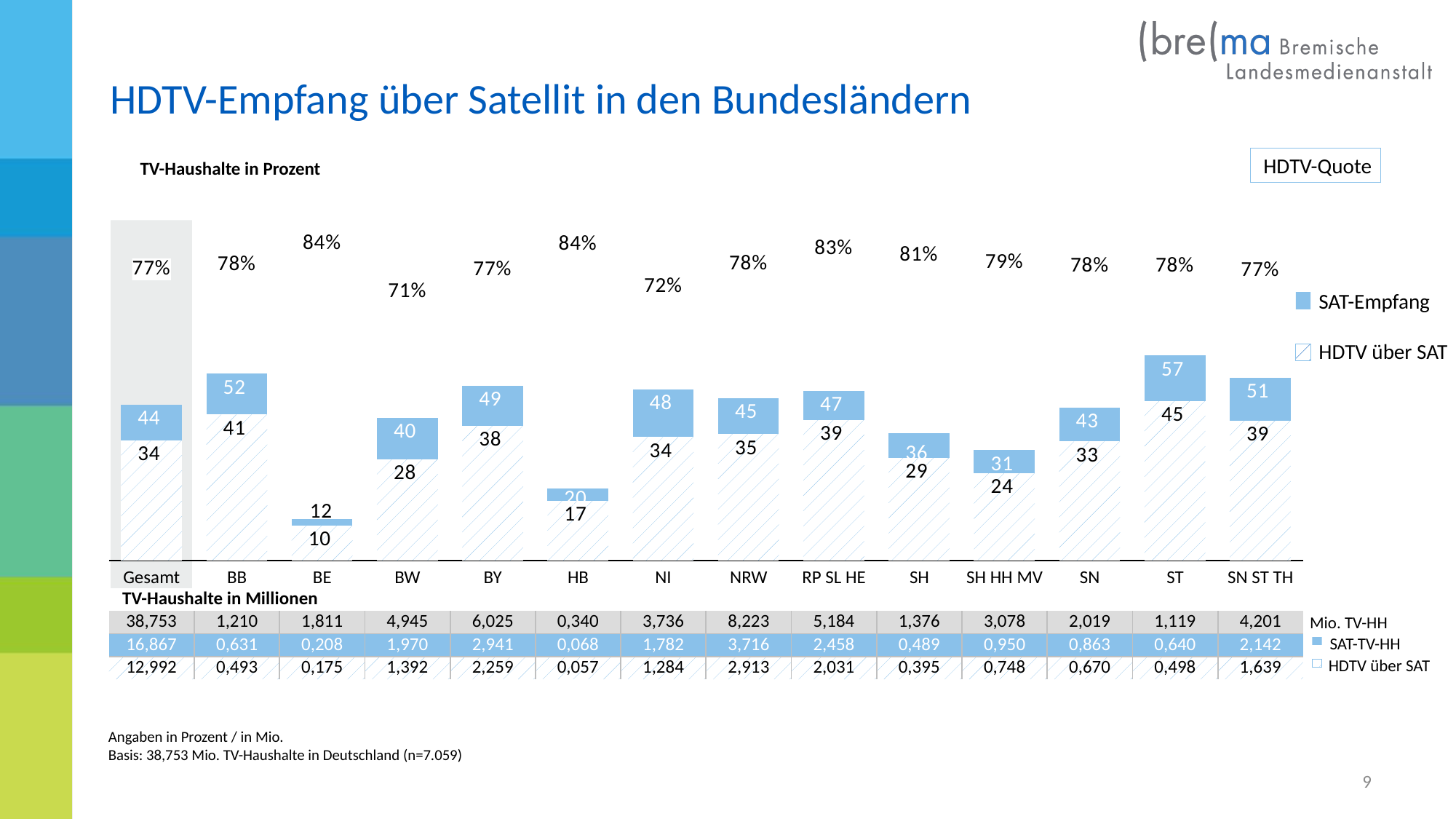
Which has the larger SAT-Empfang value, BW or NRW? NRW Which category has the highest SAT-Empfang value? ST What is the SAT-Empfang value for BB? 52 How many series does the chart legend list? 2 How many categories are shown along the x axis of the chart? 14 Which category has the lowest HDTV über SAT value? BE What is the HDTV über SAT value for BW? 28 What is the HDTV-Quote shown for HB? 84% What is the HDTV-Quote shown for Gesamt? 77% What is the difference between the SAT-Empfang and HDTV über SAT values for ST? 12 What are the two legend entries of the chart? SAT-Empfang and HDTV über SAT What kind of chart is shown on the slide? bar chart